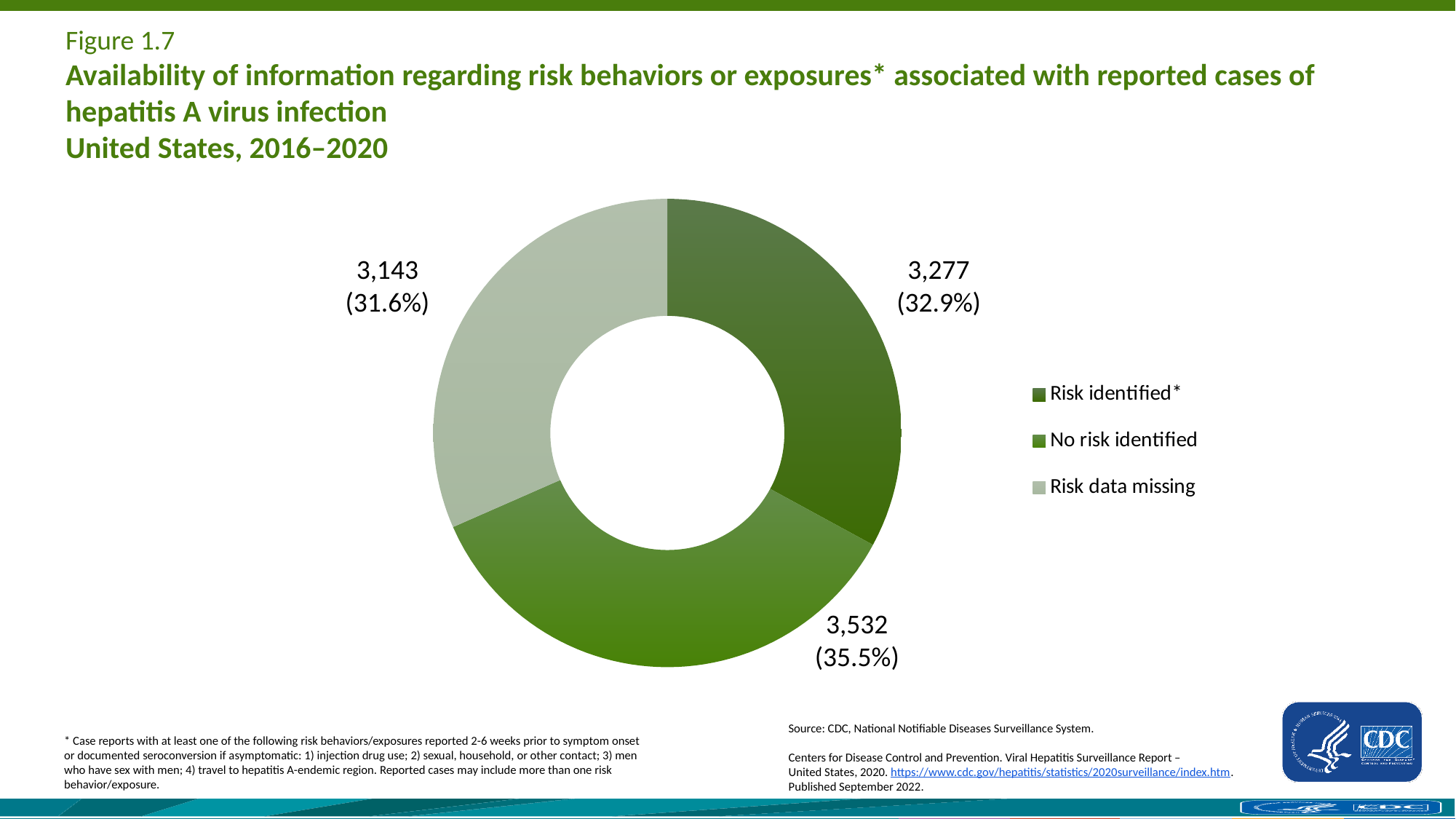
What is the difference in cases between 'No risk identified' and 'Risk identified*'? 255 How many cases are in the 'Risk identified*' category? 3,277 What kind of chart is shown on the slide? Pie chart (donut) What percentage of cases had risk data missing? 31.6% Which category has the smallest number of cases? Risk data missing Which category has the largest number of cases? No risk identified Which has more cases: 'Risk identified*' or 'Risk data missing'? Risk identified* What share of cases had a risk identified? 32.9% How many categories does the legend list? 3 What is the total number of cases across all three categories? 9,952 How many cases are in the 'Risk data missing' category? 3,143 How many cases are in the 'No risk identified' category? 3,532